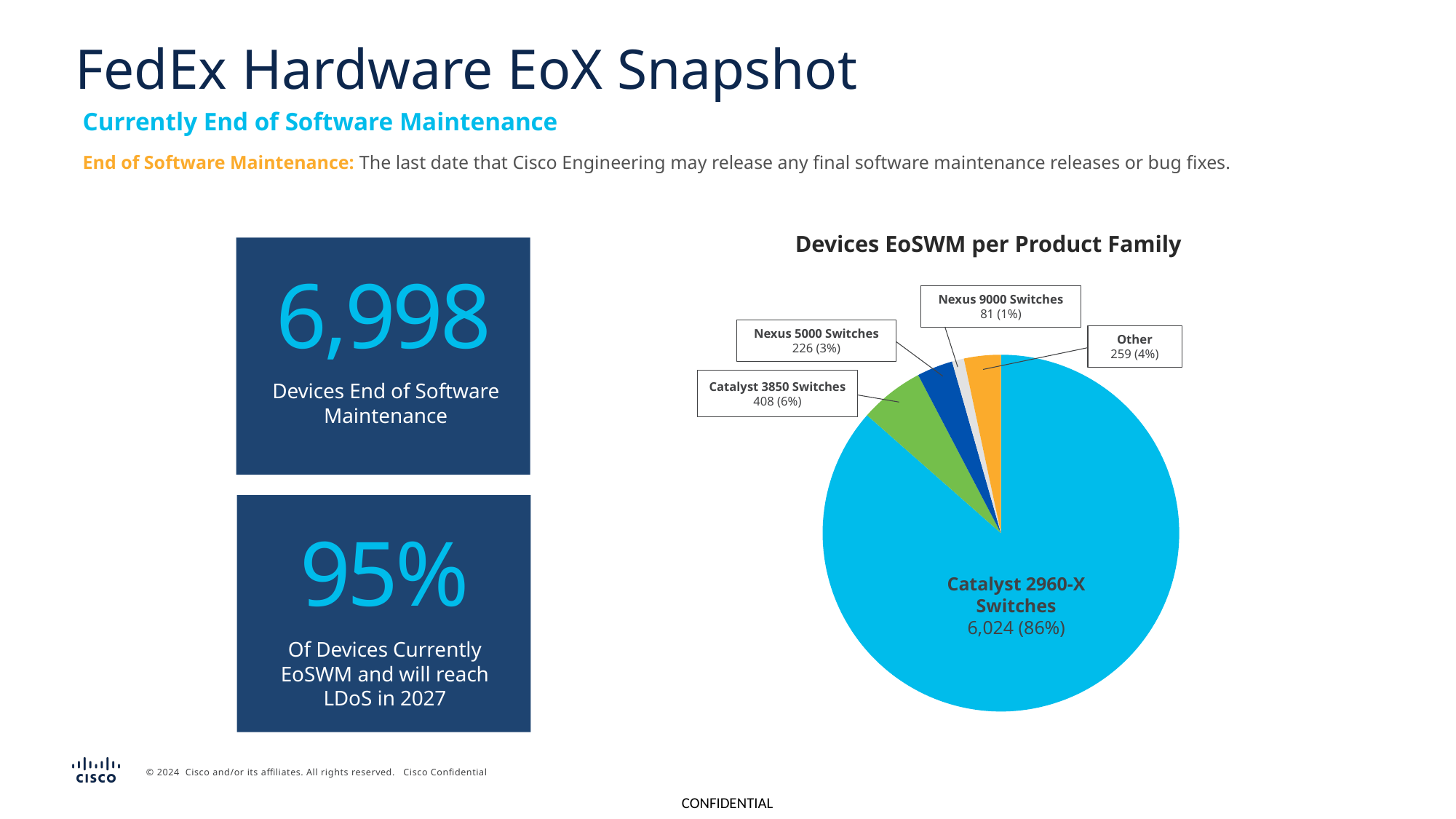
What is the difference in device count between Catalyst 3850 Switches and Nexus 5000 Switches? 182 How many devices are shown for Nexus 5000 Switches? 226 What kind of chart is "Devices EoSWM per Product Family"? pie chart What is the title of the pie chart? Devices EoSWM per Product Family Which product family has the smallest slice of the pie? Nexus 9000 Switches How many slices does the pie chart have? 5 What share of the pie does Catalyst 3850 Switches represent? 6% What share of the pie does Nexus 9000 Switches represent? 1% Which has more devices, Other or Nexus 5000 Switches? Other How many devices are shown for Catalyst 2960-X Switches in the pie chart? 6,024 How many devices are in the Other slice? 259 Which product family has the largest slice of the pie? Catalyst 2960-X Switches